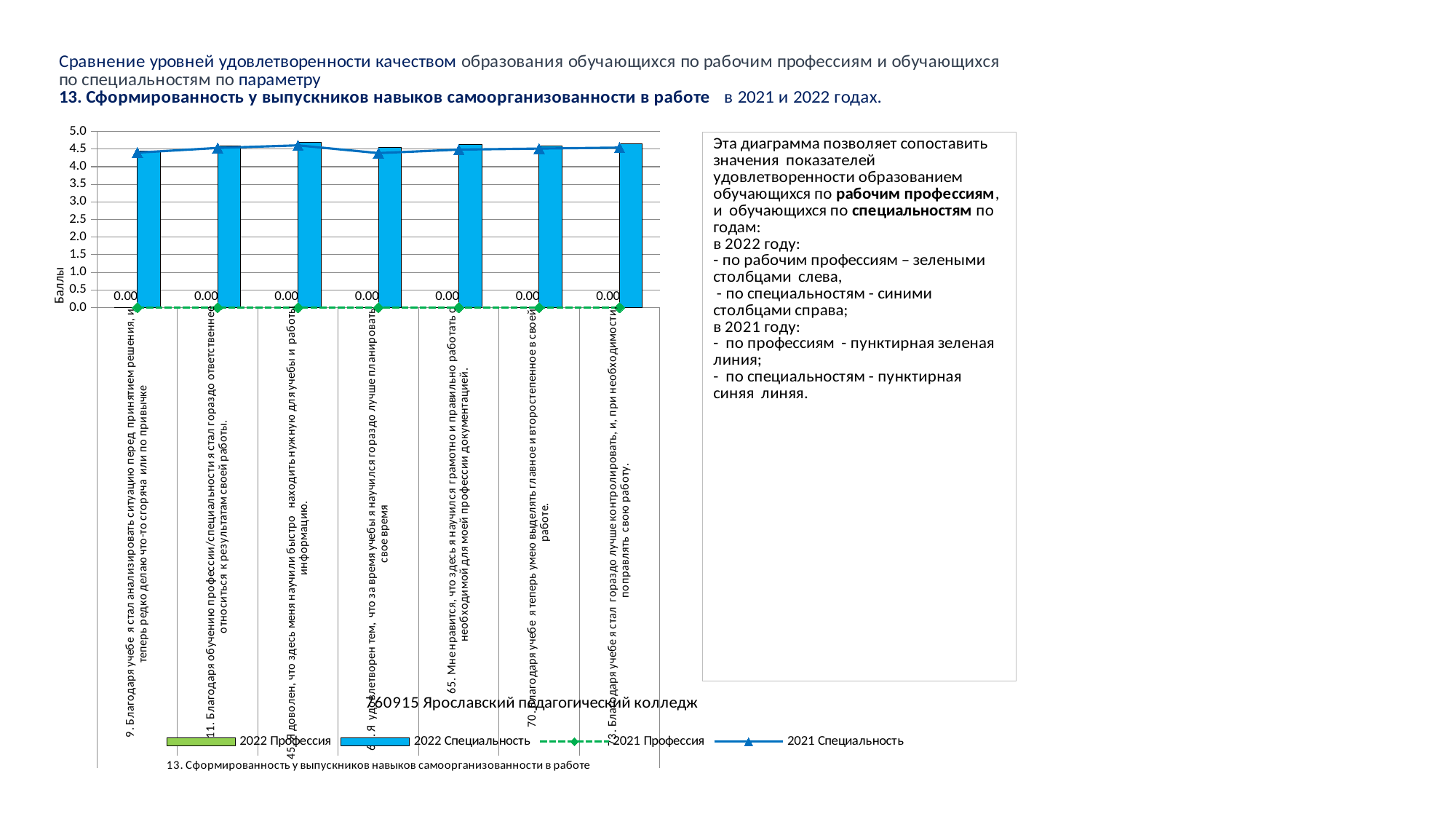
How many categories (survey statements) are plotted along the x axis? 7 What kind of chart is shown on the slide? A combined bar and line chart What is the label of the vertical axis? Баллы For statement 11, which series has the larger value: 2022 Профессия or 2022 Специальность? 2022 Специальность What is the value of the 2022 Профессия series for statement 9 (Благодаря учебе я стал анализировать ситуацию перед принятием решения)? 0.00 What is the value of the 2022 Профессия series for statement 65 (Мне нравится, что здесь я научился грамотно и правильно работать с документацией)? 0.00 Is the 2022 Специальность value for statement 70 (Благодаря учебе я теперь умею выделять главное и второстепенное) greater or less than 5.0? less How many series does the chart legend list? 4 Do the values of the 2021 Профессия series rise, fall or stay flat across the x axis? stay flat Which series is shown as a blue line with triangle markers? 2021 Специальность Is the 2022 Специальность value for statement 45 (Я доволен, что здесь меня научили быстро находить нужную информацию) greater or less than 4.0? greater